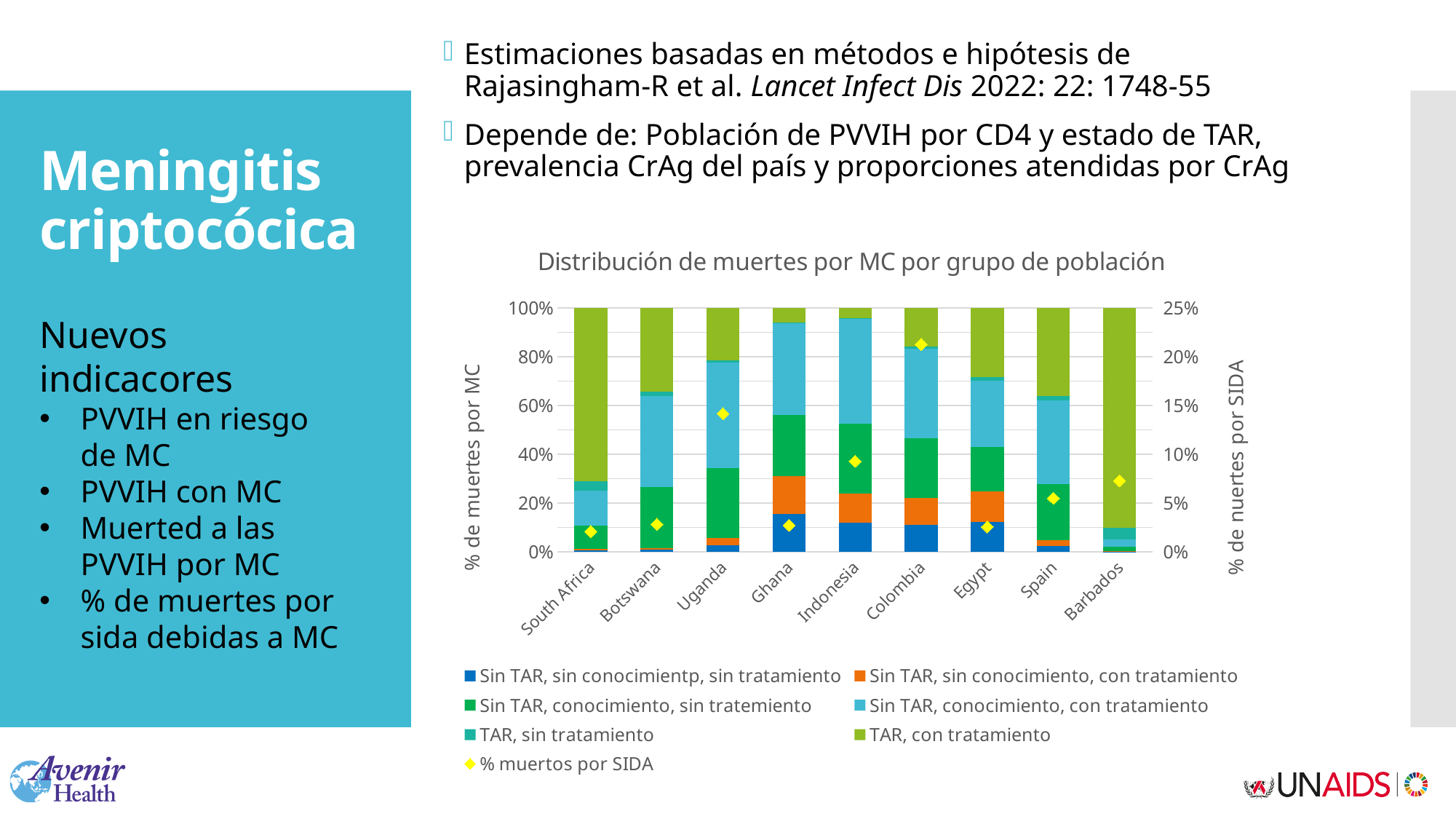
Which country has the largest share for TAR, con tratamiento? Barbados How many countries are shown on the x axis of the chart? 9 How many series does the chart legend list? 7 What kind of chart is shown on the slide? a 100% stacked bar chart combined with a marker (line) series for % muertos por SIDA on a secondary axis Is the share for TAR, con tratamiento in Barbados greater or less than 80%? greater Is the % muertos por SIDA value for South Africa greater or less than 5%? less What is the title of the chart? Distribución de muertes por MC por grupo de población Is the % muertos por SIDA value for Uganda greater or less than 10%? greater What is the label of the right-hand vertical axis? % de muertes por SIDA Which country has the highest value for % muertos por SIDA? Colombia Which country has a larger share for TAR, con tratamiento, South Africa or Uganda? South Africa